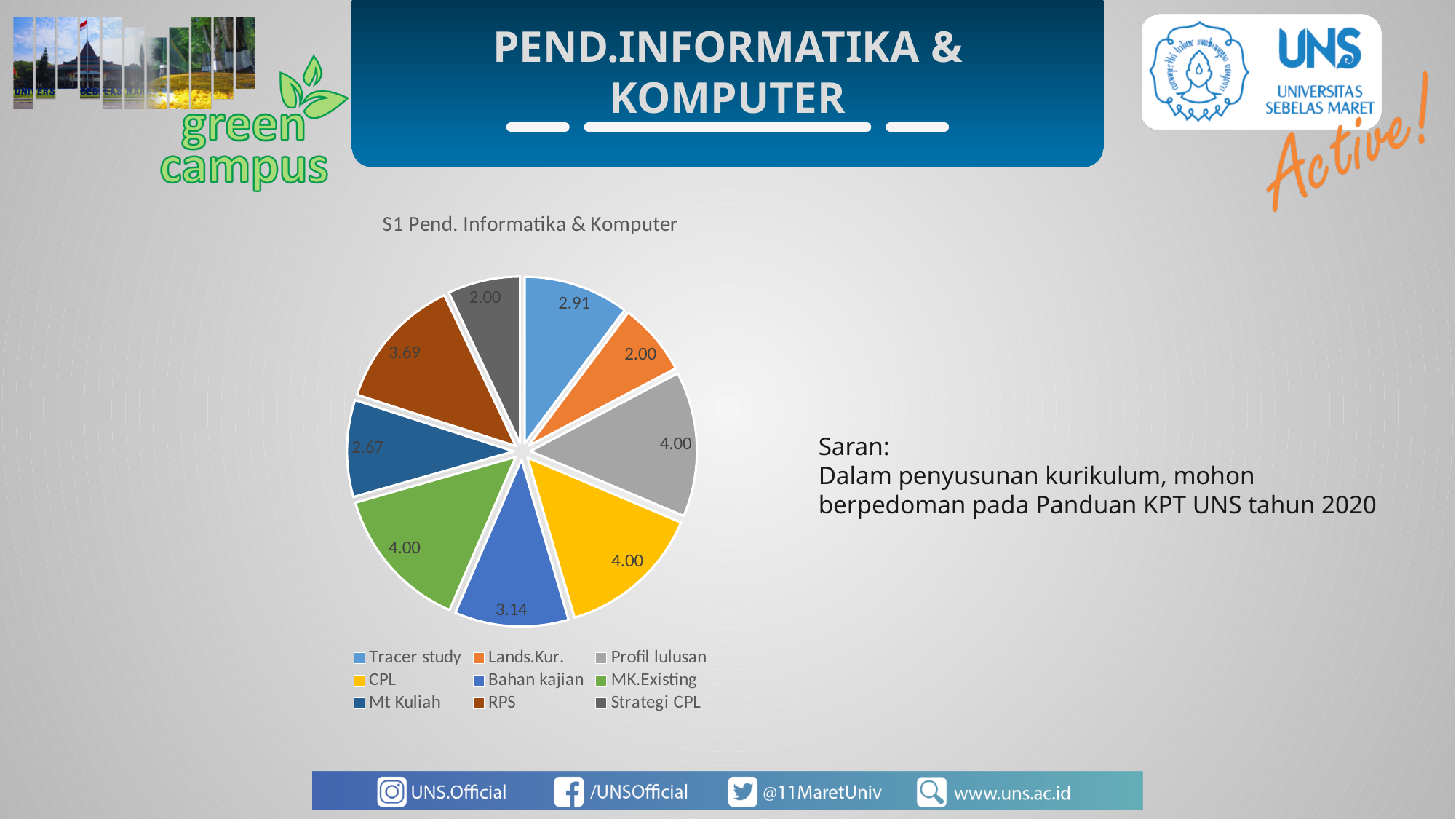
What is the value for RPS? 3.69 What is the value for Mt Kuliah? 2.67 Which is larger, the value for Bahan kajian or the value for Lands.Kur.? Bahan kajian What is the title of the chart? S1 Pend. Informatika & Komputer What is the value for Bahan kajian? 3.14 How many slices does the pie chart have? 9 What is the value for Tracer study? 2.91 What is the difference between the values for CPL and Tracer study? 1.09 Which colour represents MK.Existing in the legend? green What is the value for Strategi CPL? 2.00 What is the difference between the values for RPS and Mt Kuliah? 1.02 What type of chart is shown on the slide? pie chart